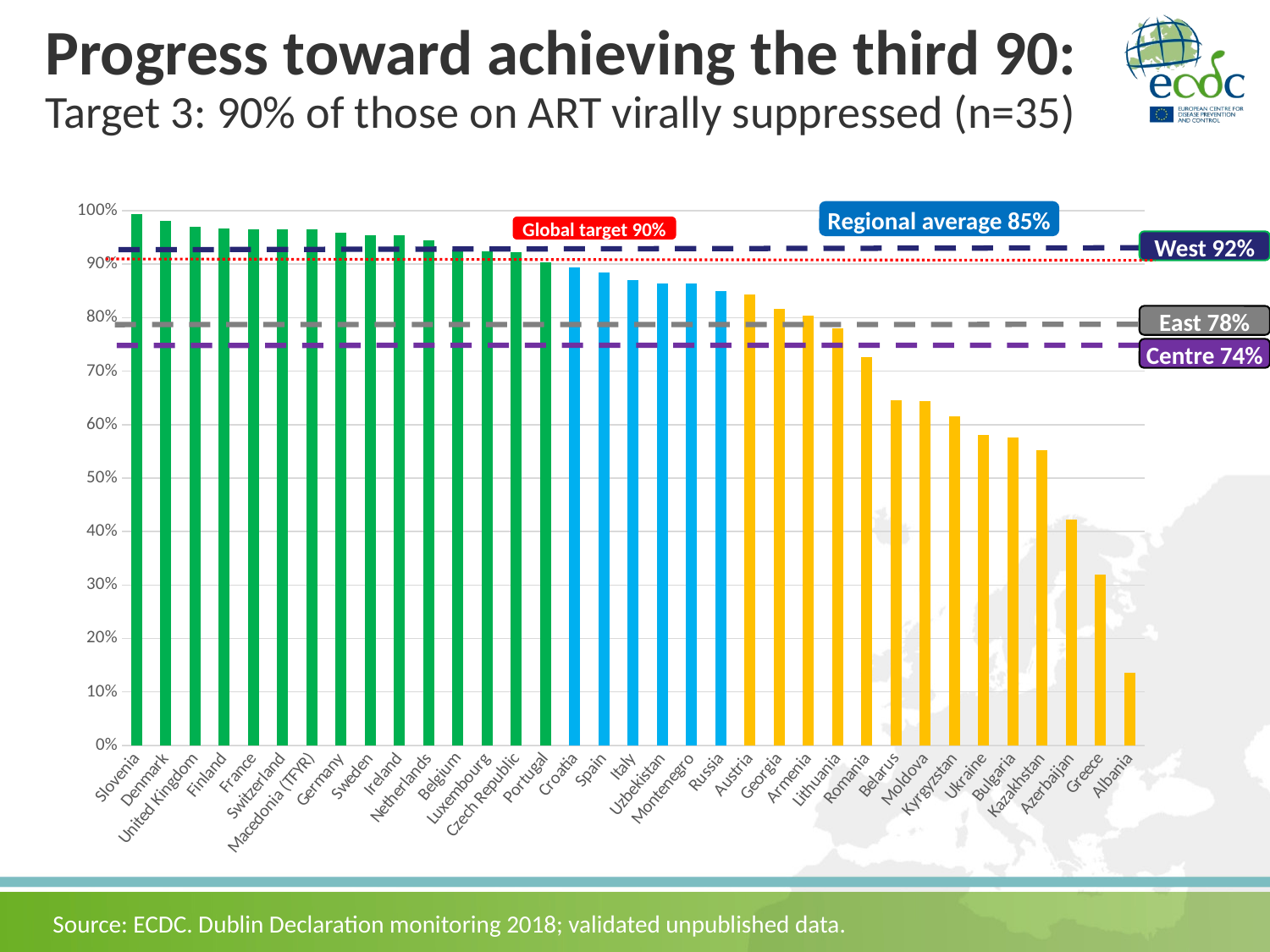
What is the regional average shown on the chart? 85% How many countries are plotted in the chart? 35 Which has a higher value, Denmark or Greece? Denmark Which country has the highest percentage of those on ART virally suppressed? Slovenia Is the value for Albania greater or less than 20%? less Is the value for Romania greater or less than 80%? less Do the bar values rise or fall from left to right across the countries? Fall Which country has the lowest percentage of those on ART virally suppressed? Albania Is the value for Greece greater or less than 40%? less What kind of chart is shown on the slide? Bar chart What value is shown for the West reference line on the chart? 92%